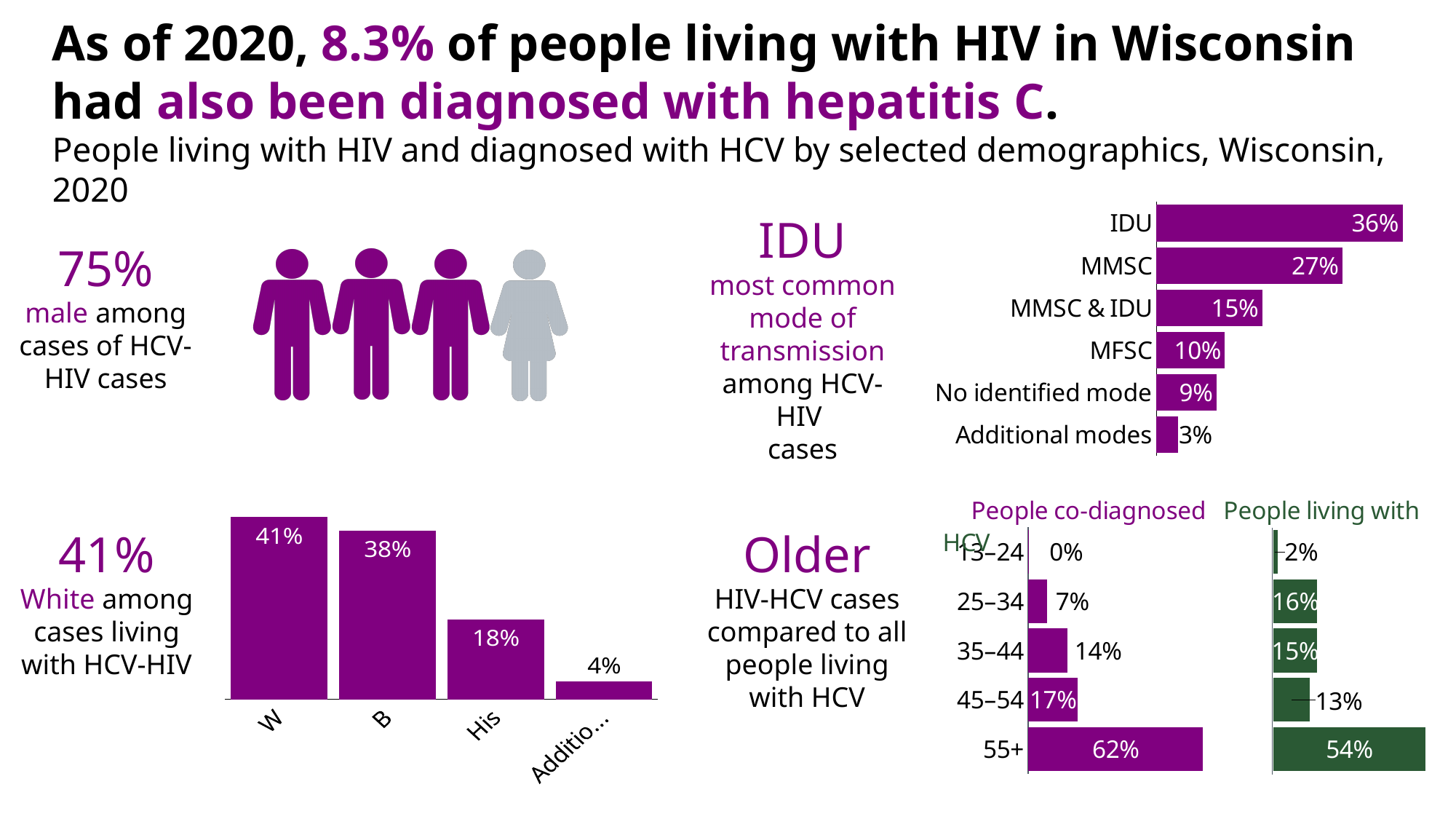
In the bottom-left bar chart by race, what is the value for His? 18% How many categories are shown in the top-right bar chart of transmission modes? 6 In the top-right bar chart of transmission modes, which category has the lowest value? Additional modes In the bottom-right 'People living with HCV' bar chart, which age group has the highest value? 55+ In the bottom-right 'People co-diagnosed HCV' bar chart, what is the value for the 45–54 age group? 17% In the bottom-left bar chart by race, what is the difference between B and His? 20% In the bottom-right charts, what is the difference between the 55+ value for people co-diagnosed with HCV and the 55+ value for people living with HCV? 8% In the top-right bar chart of transmission modes, what is the difference between IDU and MMSC & IDU? 21% What kind of chart is the bottom-left chart by race? bar chart In the bottom-left bar chart by race, which is larger, W or B? W In the top-right bar chart of transmission modes, what is the value for MMSC? 27% In the top-right bar chart of transmission modes, which category has the highest value? IDU